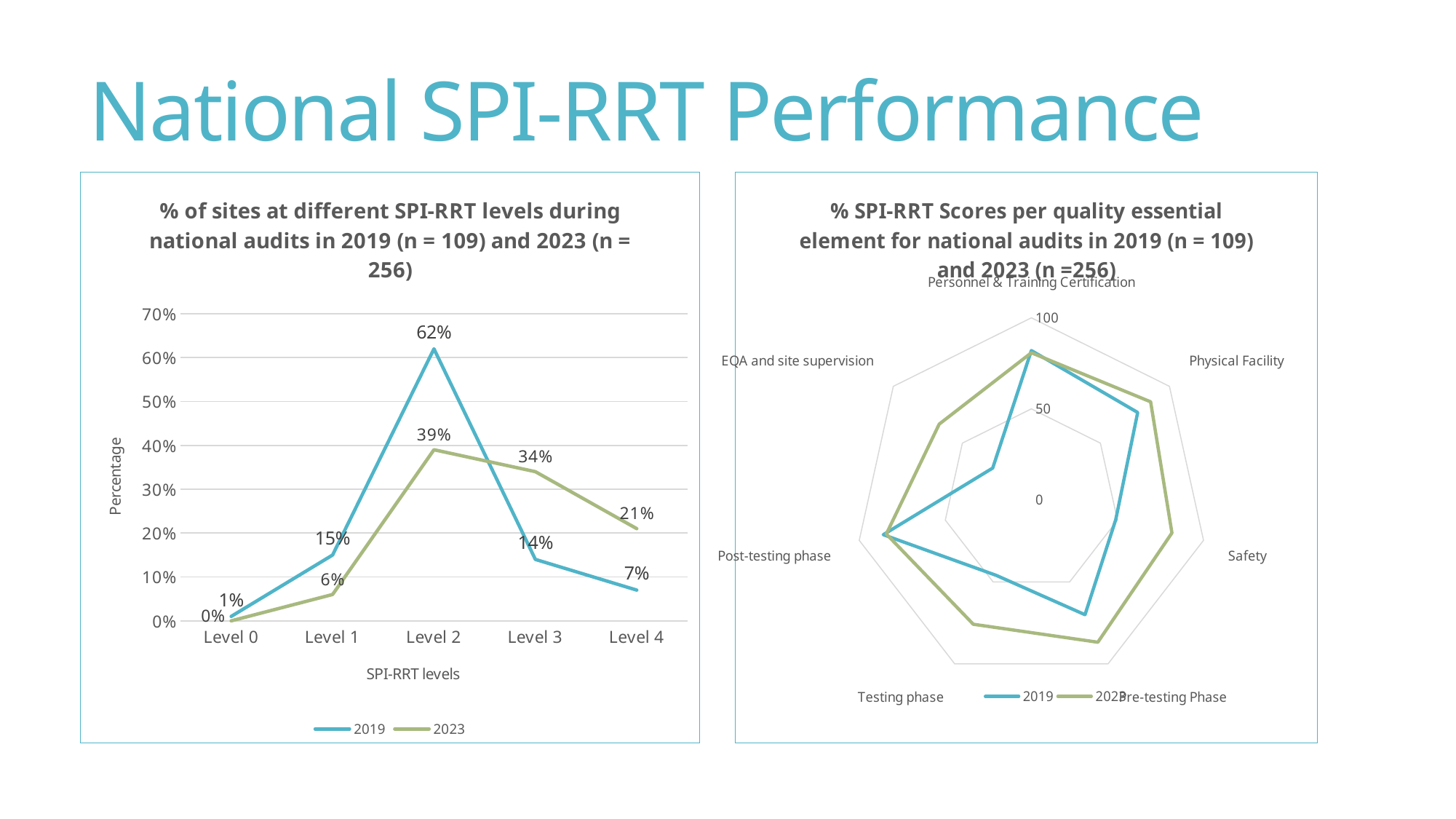
In the left chart, which SPI-RRT level had the highest percentage of sites in 2023? Level 2 How many series does the legend of the right chart list? 2 In the left chart, which SPI-RRT level had the lowest percentage of sites in 2019? Level 0 In the left chart, what percentage of sites were at Level 4 in 2019? 7% What kind of chart is the right chart, titled '% SPI-RRT Scores per quality essential element'? radar chart In the left chart, what percentage of sites were at Level 3 in 2023? 34% In the left chart, how many SPI-RRT levels are shown on the x axis? 5 In the left chart, what percentage of sites were at Level 2 in 2019? 62% In the left chart, does the 2023 line rise or fall from Level 2 to Level 4? fall In the left chart, which year had the larger percentage of sites at Level 4? 2023 In the right chart, is the 2019 score for Post-testing phase greater or less than 50? greater In the left chart, what is the difference between the 2019 and 2023 percentages at Level 2? 23%